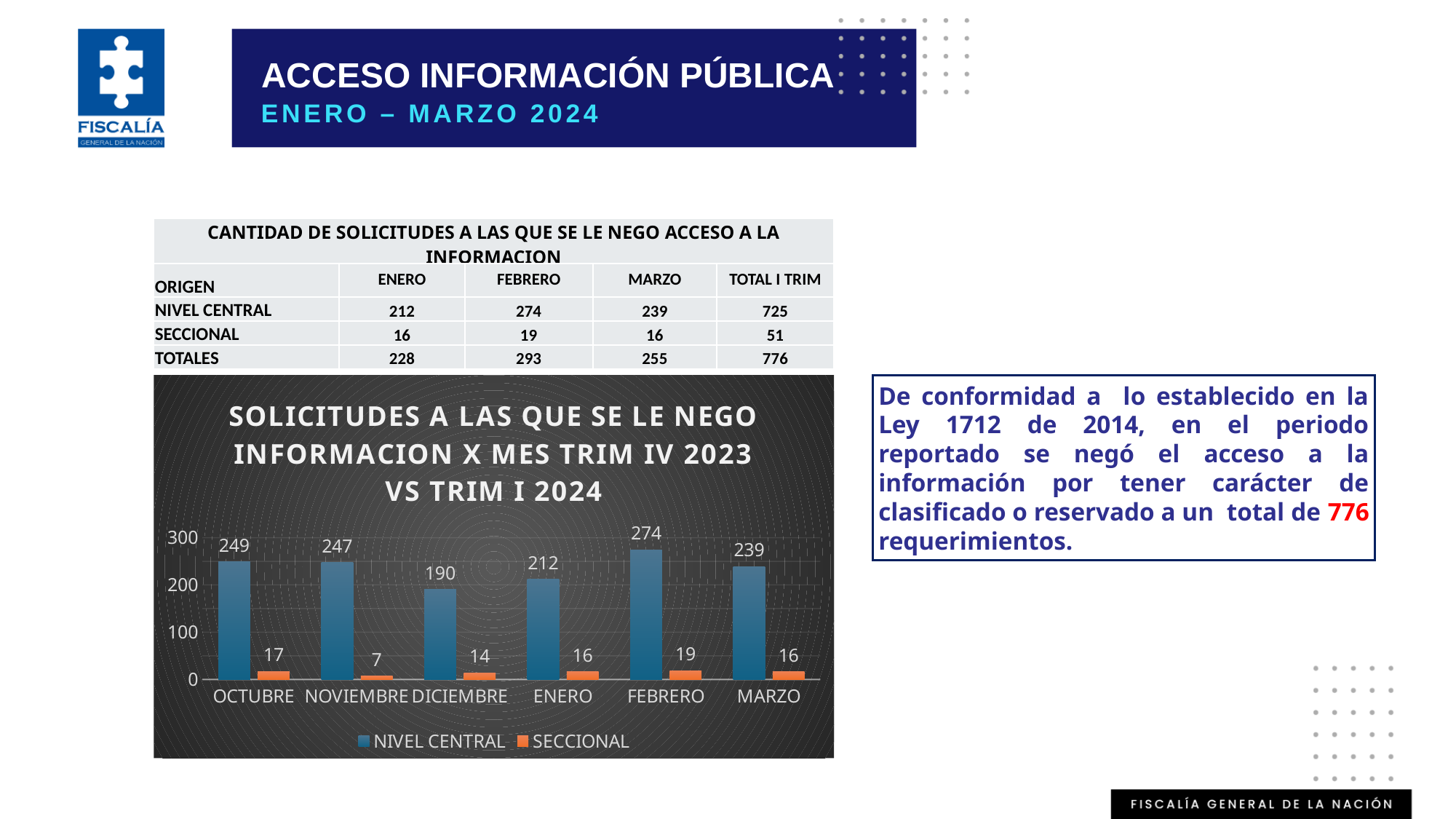
What is the NIVEL CENTRAL value for OCTUBRE? 249 Which month has the highest NIVEL CENTRAL value? FEBRERO Which month has the lowest SECCIONAL value? NOVIEMBRE What is the SECCIONAL value for NOVIEMBRE? 7 What kind of chart is shown on the slide? Bar chart How many months are shown on the x axis of the chart? 6 Which month has the lowest NIVEL CENTRAL value? DICIEMBRE Which is larger, the SECCIONAL value for OCTUBRE or for MARZO? OCTUBRE How many series does the chart legend list? 2 What is the difference between the NIVEL CENTRAL values for FEBRERO and DICIEMBRE? 84 Which series is shown in orange in the chart? SECCIONAL What is the NIVEL CENTRAL value for FEBRERO? 274